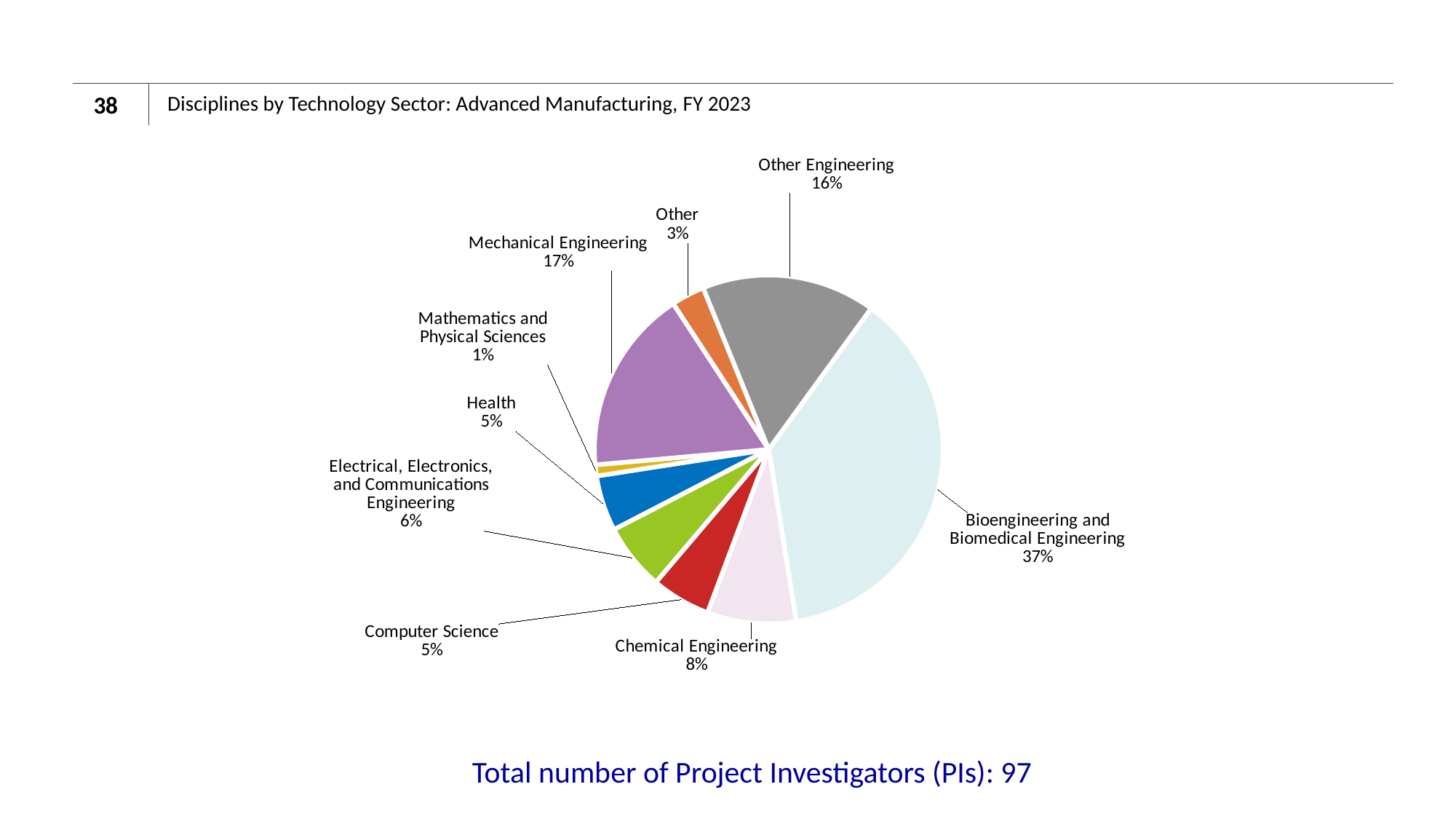
Which is larger, the share for Health or the share for Electrical, Electronics, and Communications Engineering? Electrical, Electronics, and Communications Engineering Which discipline has the largest slice of the pie? Bioengineering and Biomedical Engineering How many slices does the pie chart have? 9 What is the value shown for Mechanical Engineering? 17% What is the value shown for Chemical Engineering? 8% What share of the pie does Bioengineering and Biomedical Engineering have? 37% What is the total number of Project Investigators (PIs) stated on the slide? 97 What is the difference in percentage points between Mechanical Engineering and Other Engineering? 1 What is the value shown for Other Engineering? 16% Which discipline has the smallest slice of the pie? Mathematics and Physical Sciences What kind of chart is shown on the slide? Pie chart What is the value shown for Other? 3%